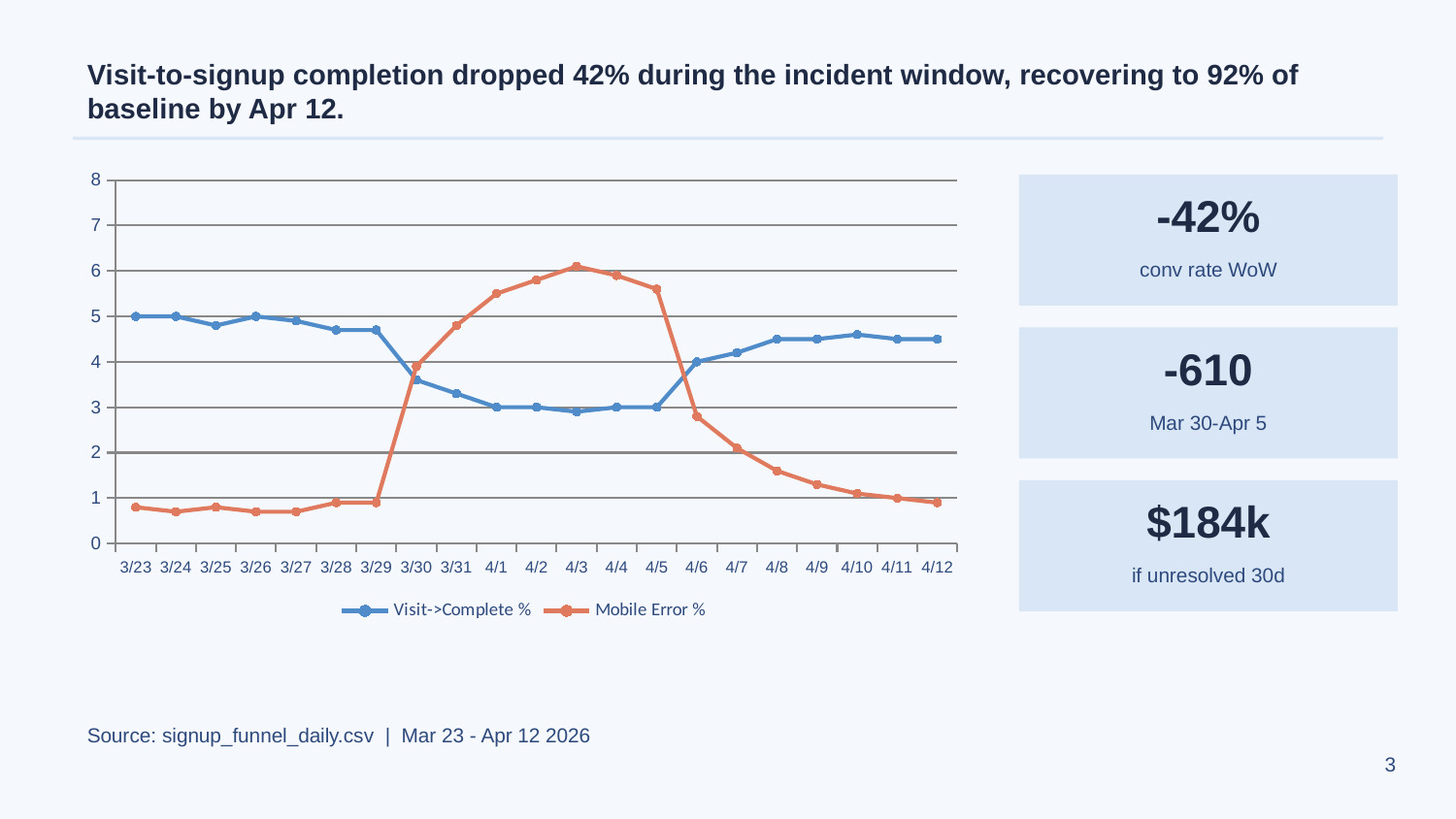
What are the two series names shown in the chart legend? Visit->Complete % and Mobile Error % What kind of chart is shown on the slide? line chart What is the Visit->Complete % value on 4/6? 4 Is the Mobile Error % value on 3/23 greater or less than 1? less On 4/3, which series has the higher value, Visit->Complete % or Mobile Error %? Mobile Error % On which date does Mobile Error % reach its highest value? 4/3 On 3/23, which series has the higher value, Visit->Complete % or Mobile Error %? Visit->Complete % Does Mobile Error % rise or fall from 4/3 to 4/12? fall How many dates are plotted along the x axis of the chart? 21 How many series does the chart legend list? 2 Is the Mobile Error % value on 4/3 greater or less than 5? greater What is the Visit->Complete % value on 3/23? 5